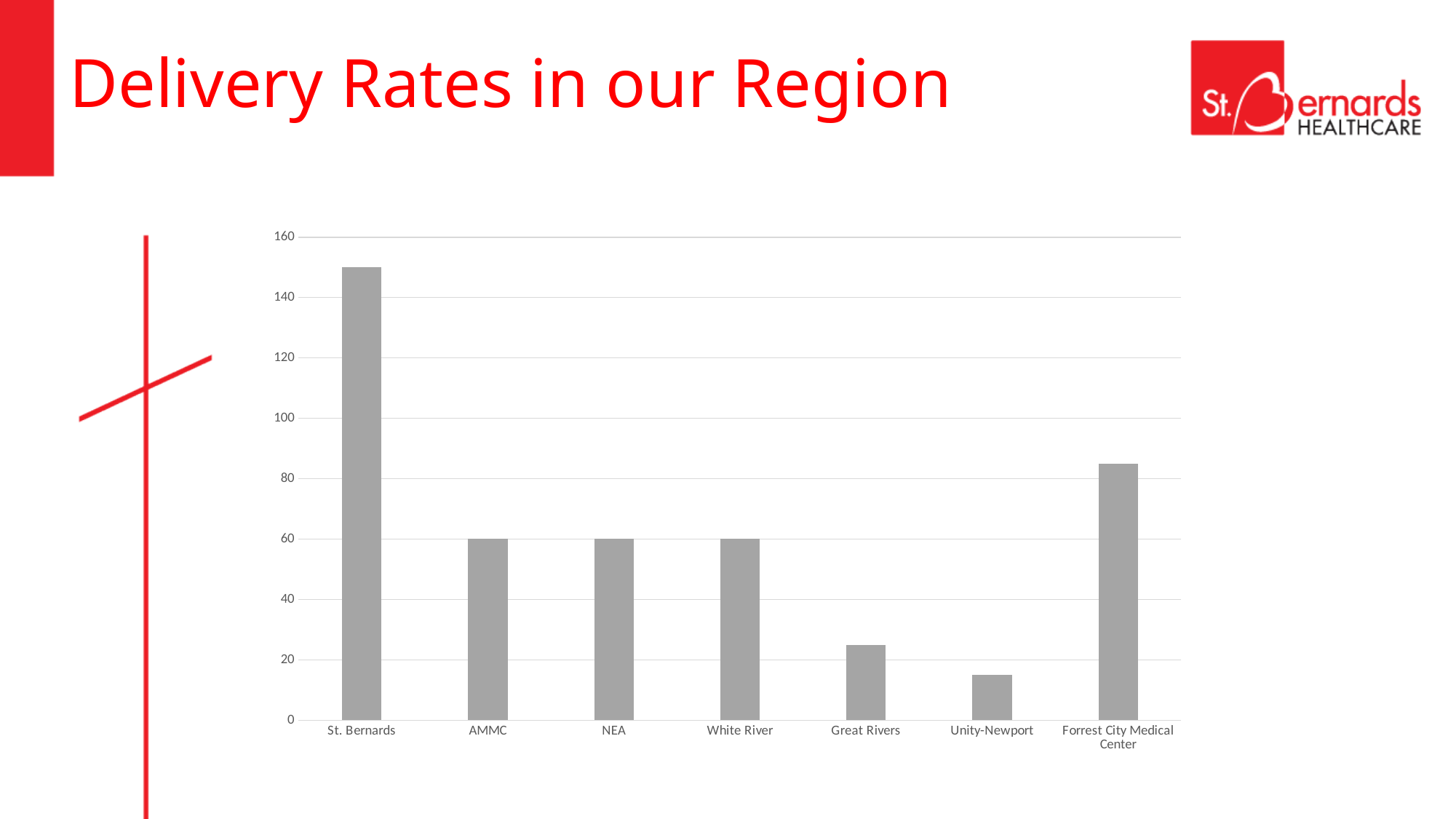
Is the value for Unity-Newport greater or less than 20? less What kind of chart is shown on the slide? bar chart How many hospitals (categories) are shown on the x axis of the chart? 7 Is the value for Forrest City Medical Center greater or less than 80? greater Is the value for Great Rivers greater or less than 40? less Which is larger, the value for Forrest City Medical Center or the value for NEA? Forrest City Medical Center What is the value for White River? 60 Which hospital has the lowest value in the chart? Unity-Newport What is the value for AMMC? 60 Which hospital has the highest value in the chart? St. Bernards What is the title of the slide containing the chart? Delivery Rates in our Region